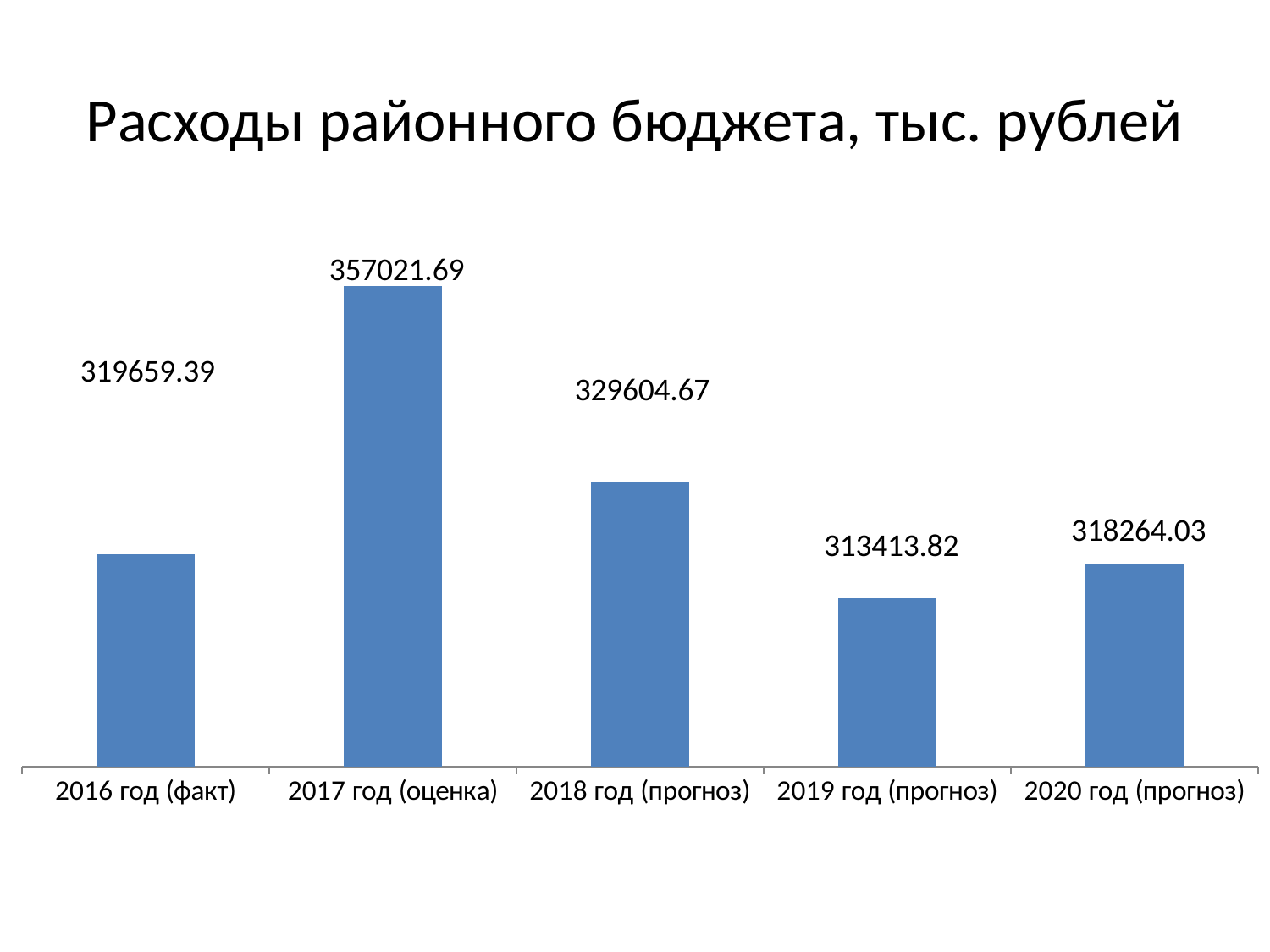
What is the difference between the values for 2017 год (оценка) and 2016 год (факт)? 37362.30 What is the value for 2020 год (прогноз)? 318264.03 Which is larger, the value for 2018 год (прогноз) or 2019 год (прогноз)? 2018 год (прогноз) What is the value for 2019 год (прогноз)? 313413.82 Which category has the highest value? 2017 год (оценка) What is the value for 2017 год (оценка)? 357021.69 What is the difference between the values for 2018 год (прогноз) and 2019 год (прогноз)? 16190.85 How many categories are shown on the chart? 5 What is the title of the chart? Расходы районного бюджета, тыс. рублей What is the value for 2016 год (факт)? 319659.39 Which category has the lowest value? 2019 год (прогноз) What kind of chart is shown on the slide? Bar chart